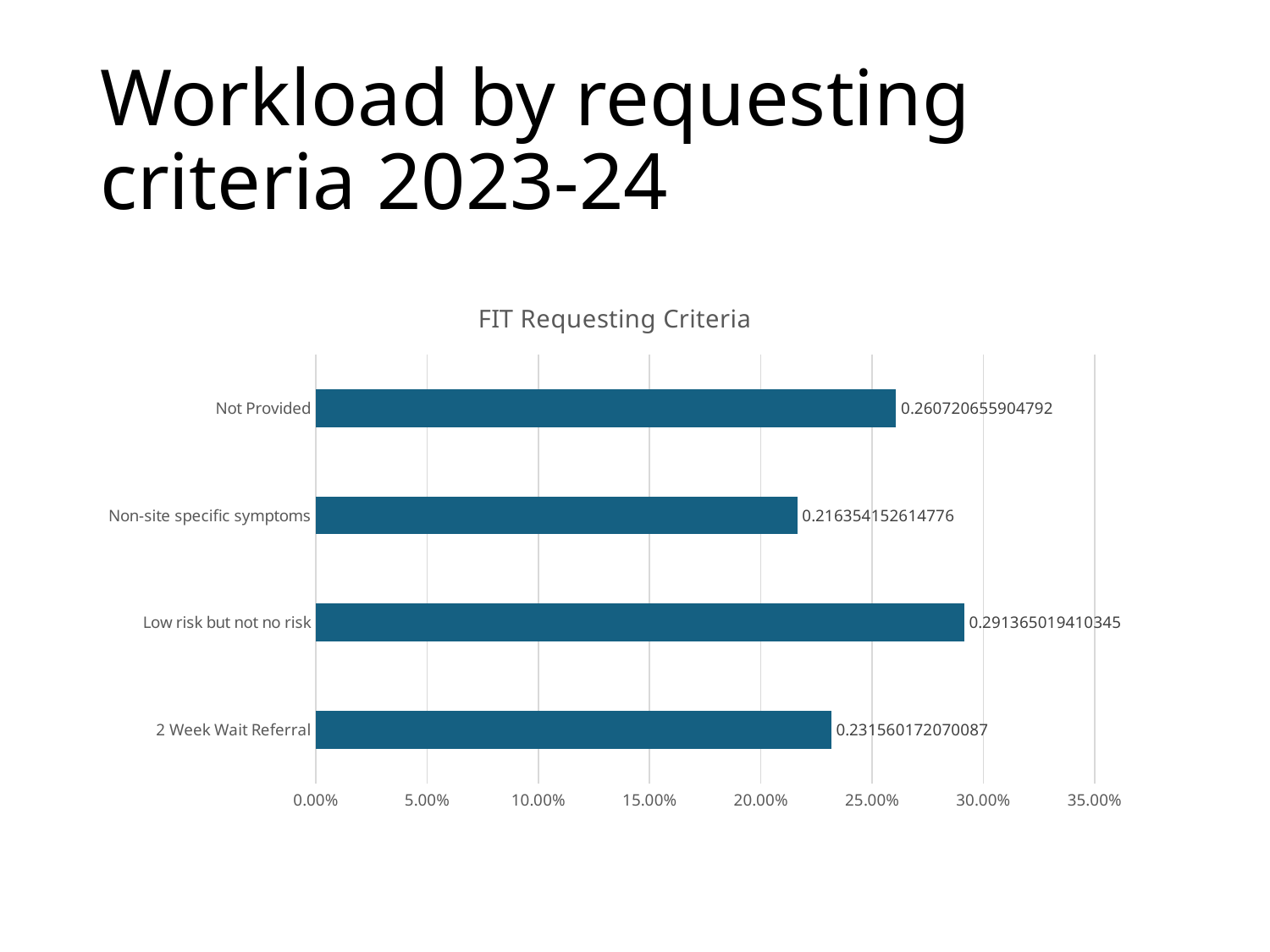
Which is larger, the value for Not Provided or the value for 2 Week Wait Referral? Not Provided What is the value shown for Low risk but not no risk? 0.291365019410345 What kind of chart is shown on the slide? Bar chart What is the title of the chart? FIT Requesting Criteria Which requesting criterion has the highest value? Low risk but not no risk What is the value shown for Not Provided? 0.260720655904792 Is the value for Low risk but not no risk greater or less than 30.00%? less What is the value shown for Non-site specific symptoms? 0.216354152614776 How many requesting criteria are plotted in the chart? 4 Which requesting criterion has the lowest value? Non-site specific symptoms Is the value for Not Provided greater or less than 25.00%? greater What is the value shown for 2 Week Wait Referral? 0.231560172070087